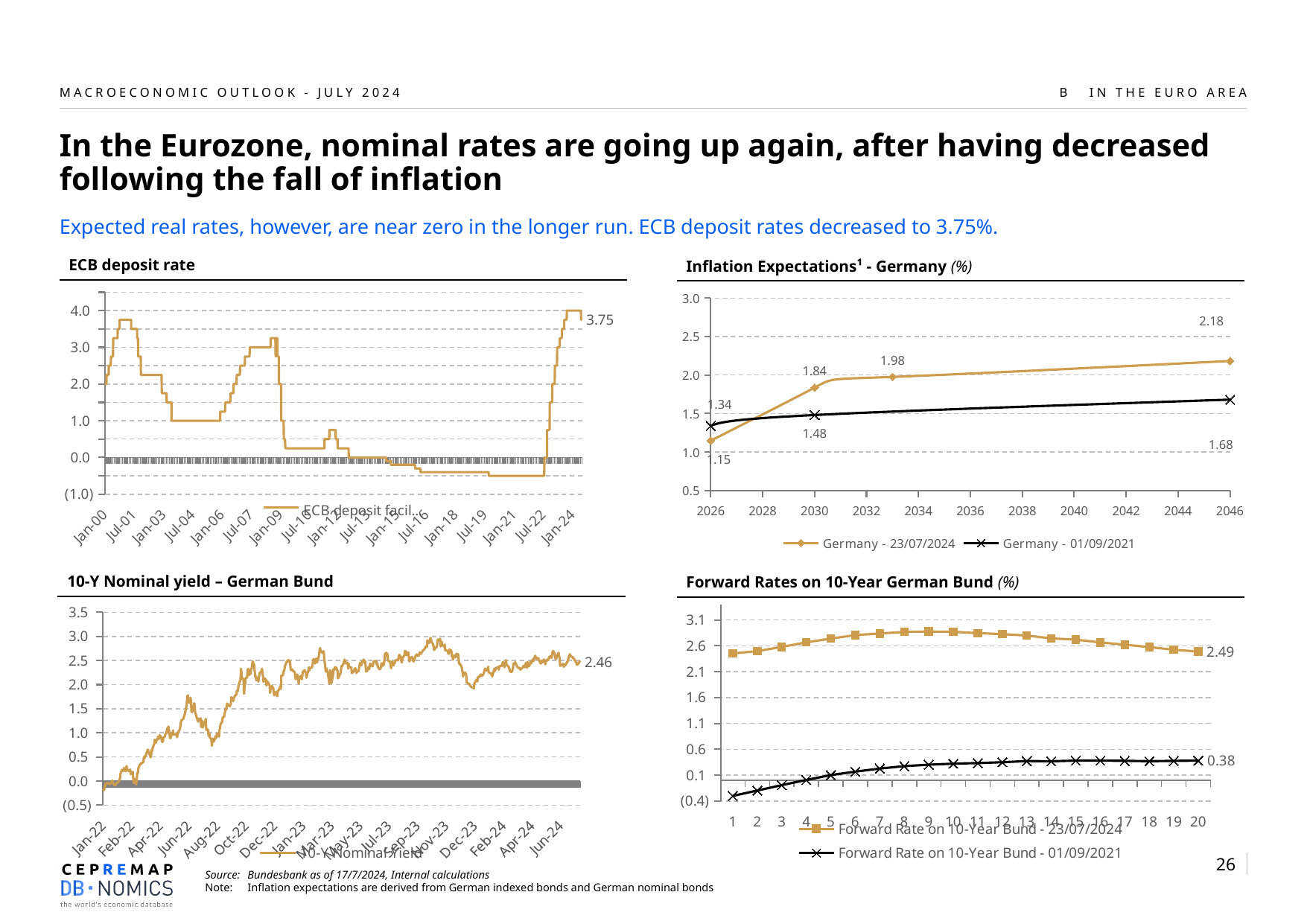
On the Inflation Expectations - Germany chart, what is the difference between the 2046 values of the 23/07/2024 and 01/09/2021 series? 0.50 On the Inflation Expectations - Germany chart, what is the value for Germany - 01/09/2021 in 2046? 1.68 On the ECB deposit rate chart, what is the latest value labelled at the end of the line? 3.75 How many series does the legend of the Inflation Expectations - Germany chart list? 2 On the Inflation Expectations - Germany chart, which series has the higher value in 2026? Germany - 01/09/2021 On the Forward Rates on 10-Year German Bund chart, what is the difference between the end values of the 23/07/2024 and 01/09/2021 series? 2.11 On the Forward Rates on 10-Year German Bund chart, what is the value labelled at the end of the 23/07/2024 series? 2.49 On the Inflation Expectations - Germany chart, what is the value for Germany - 23/07/2024 in 2046? 2.18 What kind of chart is the ECB deposit rate chart? Line chart On the 10-Y Nominal yield – German Bund chart, what is the value labelled at the end of the line? 2.46 On the Inflation Expectations - Germany chart, what is the value for Germany - 23/07/2024 in 2030? 1.84 On the Forward Rates on 10-Year German Bund chart, does the 01/09/2021 series rise or fall from year 1 to year 20? Rise